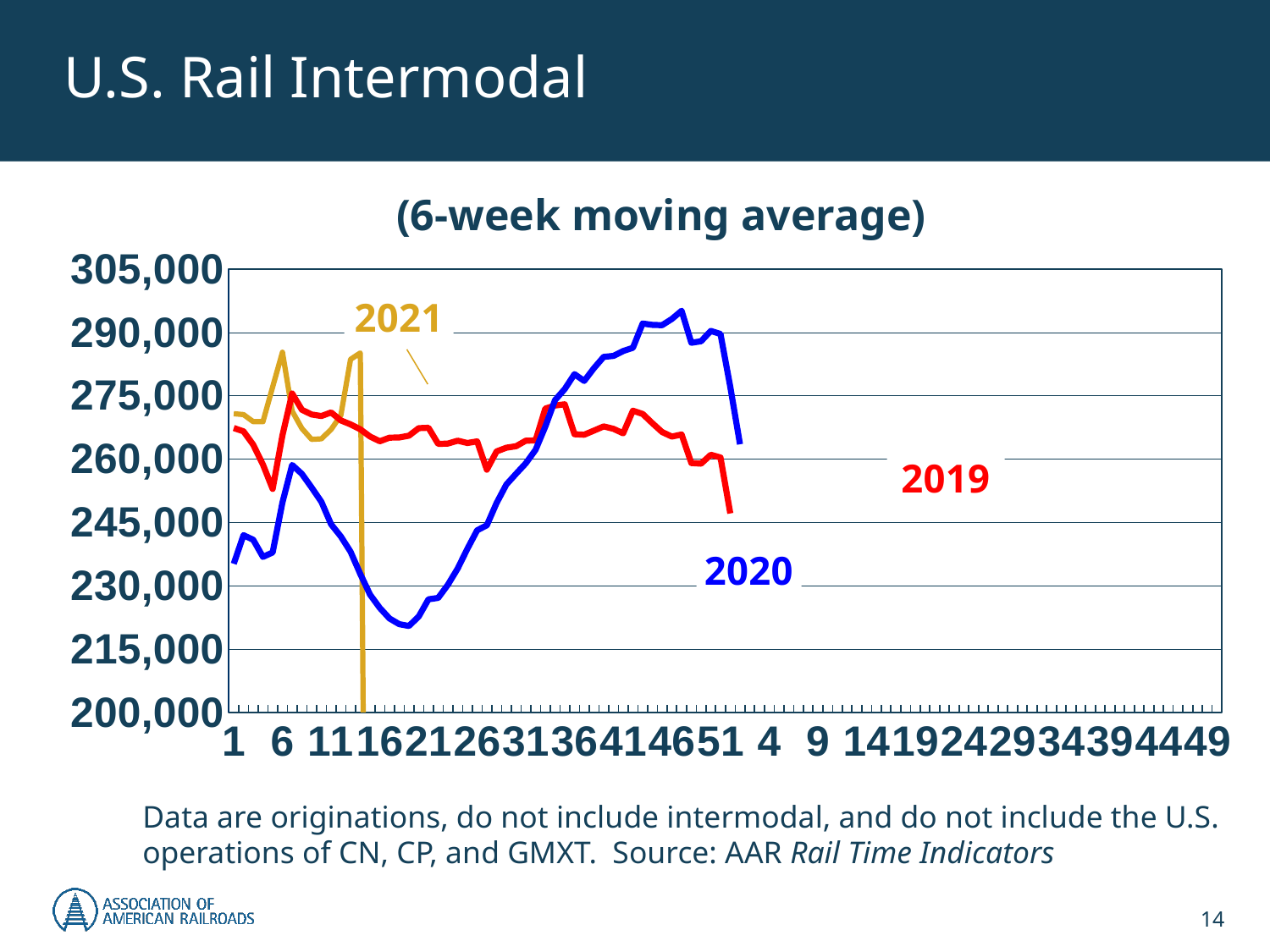
Does the 2020 line rise or fall between week 1 and week 20? fall Is the value of the 2020 line at week 1 greater or less than 245,000? less What colour is the line for 2019? red What is the title printed above the chart? (6-week moving average) Is the lowest value of the 2020 line greater or less than 230,000? less How many data series (years) are plotted on the chart? 3 At week 1, which line is higher, 2019 or 2020? 2019 Is the peak value of the 2021 line greater or less than 275,000? greater What kind of chart is shown on the slide? line chart Which series reaches the highest value anywhere on the chart? 2020